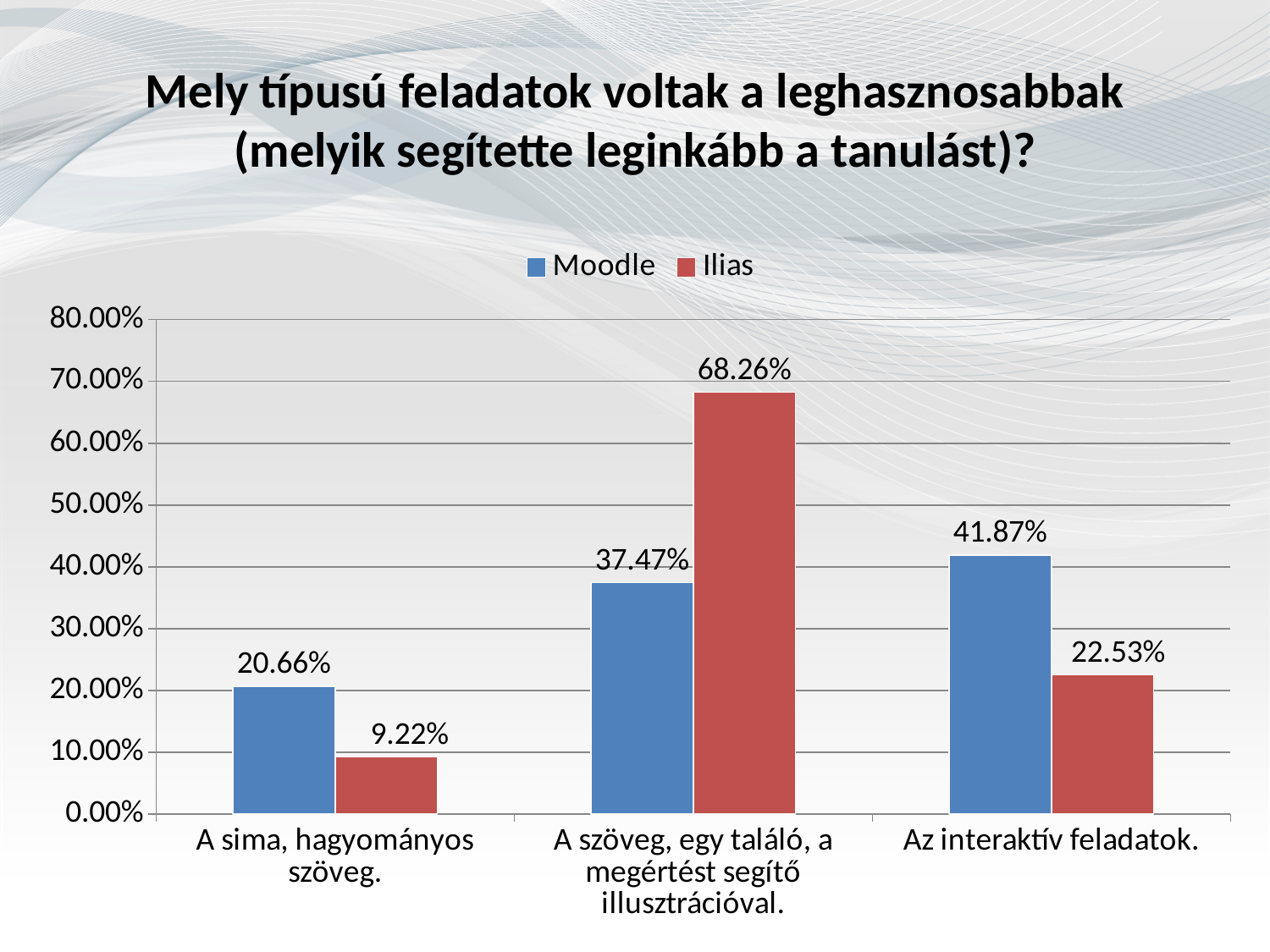
Which category has the lowest Ilias value? A sima, hagyományos szöveg. What kind of chart is shown on the slide? bar chart How many categories are shown on the x axis? 3 Which category has the highest Moodle value? Az interaktív feladatok. What is the Ilias value for "A szöveg, egy találó, a megértést segítő illusztrációval."? 68.26% Is the Moodle value for "A szöveg, egy találó, a megértést segítő illusztrációval." greater or less than 40.00%? less How many series does the legend list? 2 What is the difference between the Ilias and Moodle values for "A szöveg, egy találó, a megértést segítő illusztrációval."? 30.79% What is the difference between the Moodle and Ilias values for "Az interaktív feladatok."? 19.34% What is the Ilias value for "Az interaktív feladatok."? 22.53% For "A sima, hagyományos szöveg.", which is larger, the Moodle value or the Ilias value? Moodle What is the Moodle value for "A sima, hagyományos szöveg."? 20.66%